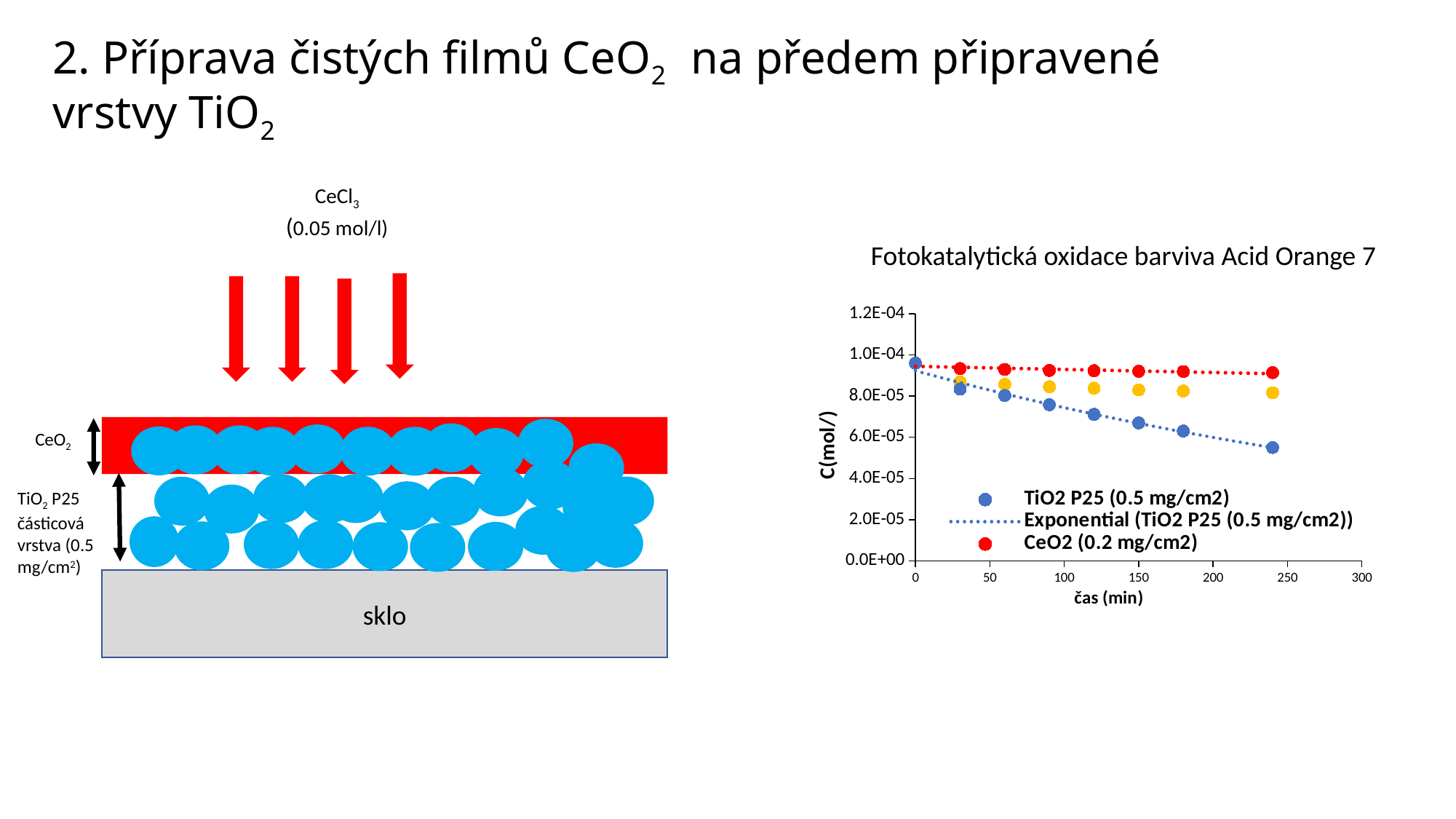
What kind of chart is shown on the slide? scatter chart How many entries does the chart legend list? 3 Is the value of the TiO2 P25 (0.5 mg/cm2) series at 240 min greater or less than 6.0E-05? less Is the value of the CeO2 (0.2 mg/cm2) series at 240 min greater or less than 8.0E-05? greater At 180 min, which series has the lower value: TiO2 P25 (0.5 mg/cm2) or CeO2 (0.2 mg/cm2)? TiO2 P25 (0.5 mg/cm2) What is the label of the x axis of the chart? čas (min) What is the title of the chart on the slide? Fotokatalytická oxidace barviva Acid Orange 7 How many data points are plotted for the TiO2 P25 (0.5 mg/cm2) series? 8 At 240 min, which series has the larger value: TiO2 P25 (0.5 mg/cm2) or CeO2 (0.2 mg/cm2)? CeO2 (0.2 mg/cm2) Do the values of the TiO2 P25 (0.5 mg/cm2) series rise or fall as time increases? fall Is the value of the TiO2 P25 (0.5 mg/cm2) series at 0 min greater or less than 8.0E-05? greater